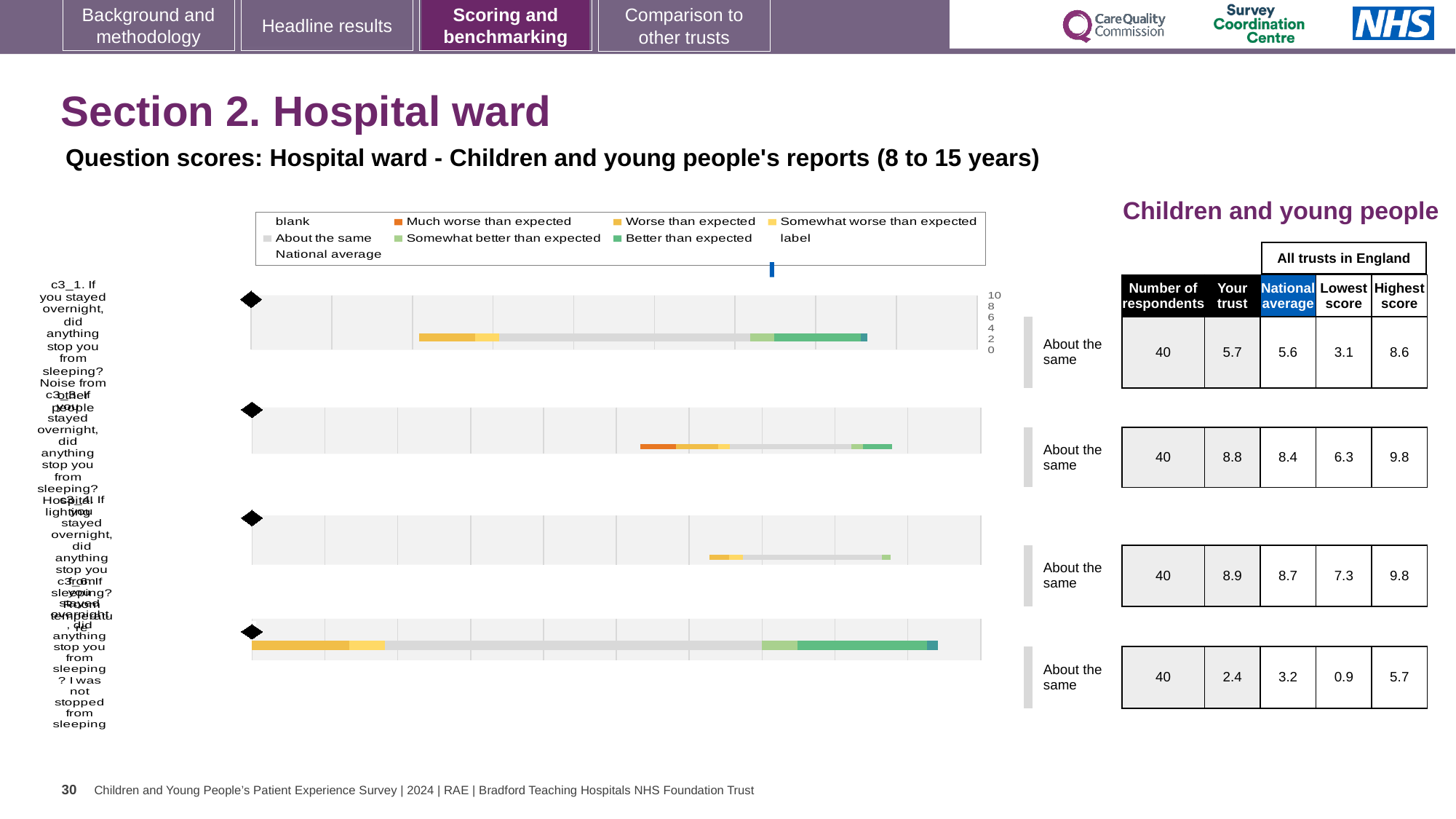
In the table beside the charts, is the 'Your trust' score for the second row (8.8) larger or smaller than its national average (8.4)? larger In the table beside the charts, what is the 'Your trust' score for the first chart row (c3_1)? 5.7 How many separate benchmark charts are shown on the slide? 4 Which legend entry is shown in orange? Much worse than expected In the table beside the charts, what is the 'Your trust' score for the fourth chart row (c3_6)? 2.4 What kind of chart is used in the four benchmark charts on the slide? bar chart How many entries does the legend above the charts list? 9 What is the highest value shown on the axis scale to the right of the first chart? 10 In the table beside the charts, what is the difference between the highest score (9.8) and the lowest score (7.3) for the third chart row? 2.5 Which legend entry is shown in light grey? About the same What benchmark rating is given beside the first chart (c3_1, noise from other people)? About the same In the table beside the charts, which chart row has the highest 'Your trust' score? the third row (c3_4), 8.9